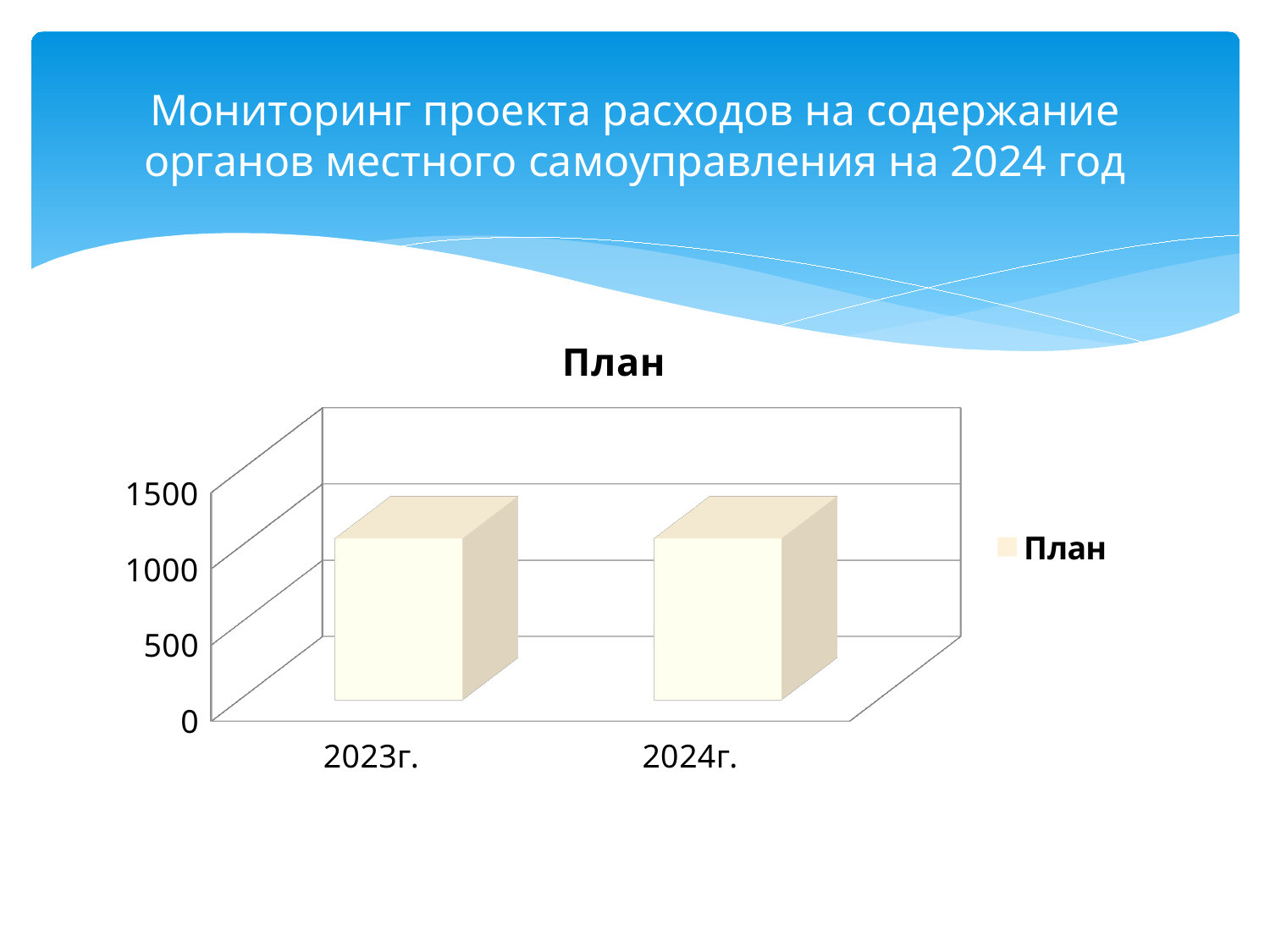
What is the title of the chart? План Is the value for 2024г. greater or less than 1500? less How many series does the chart legend list? 1 How many categories are shown on the x axis of the chart? 2 Is the value for 2023г. greater or less than 500? greater Is the value for 2024г. greater or less than 500? greater What kind of chart is shown on the slide? bar chart What is the name of the series listed in the chart legend? План What is the highest value shown on the vertical axis of the chart? 1500